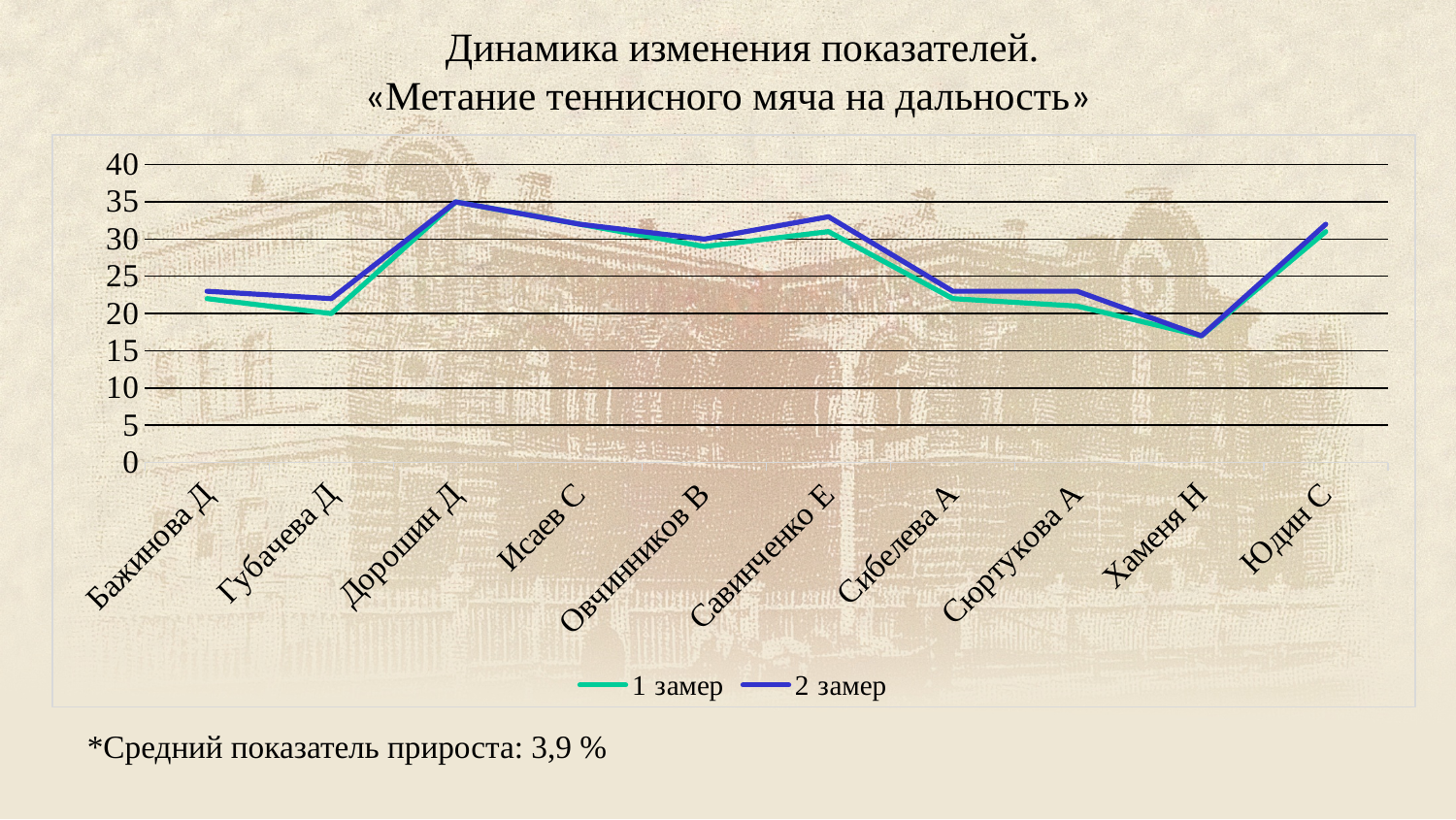
Which is larger for the series "1 замер": the value for Дорошин Д or the value for Хаменя Н? Дорошин Д Do the values of the series "2 замер" rise or fall from Хаменя Н to Юдин С? rise What kind of chart is shown on the slide? line chart Which category has the lowest value for the series "2 замер"? Хаменя Н Is the value for Хаменя Н in the series "2 замер" greater or less than 20? less Is the value for Дорошин Д in the series "1 замер" greater or less than 30? greater Is the value for Савинченко Е in the series "2 замер" greater or less than 30? greater Which category has the highest value for the series "1 замер"? Дорошин Д How many categories (names) are shown along the x axis? 10 How many series does the legend list? 2 What are the two series names listed in the legend? 1 замер, 2 замер